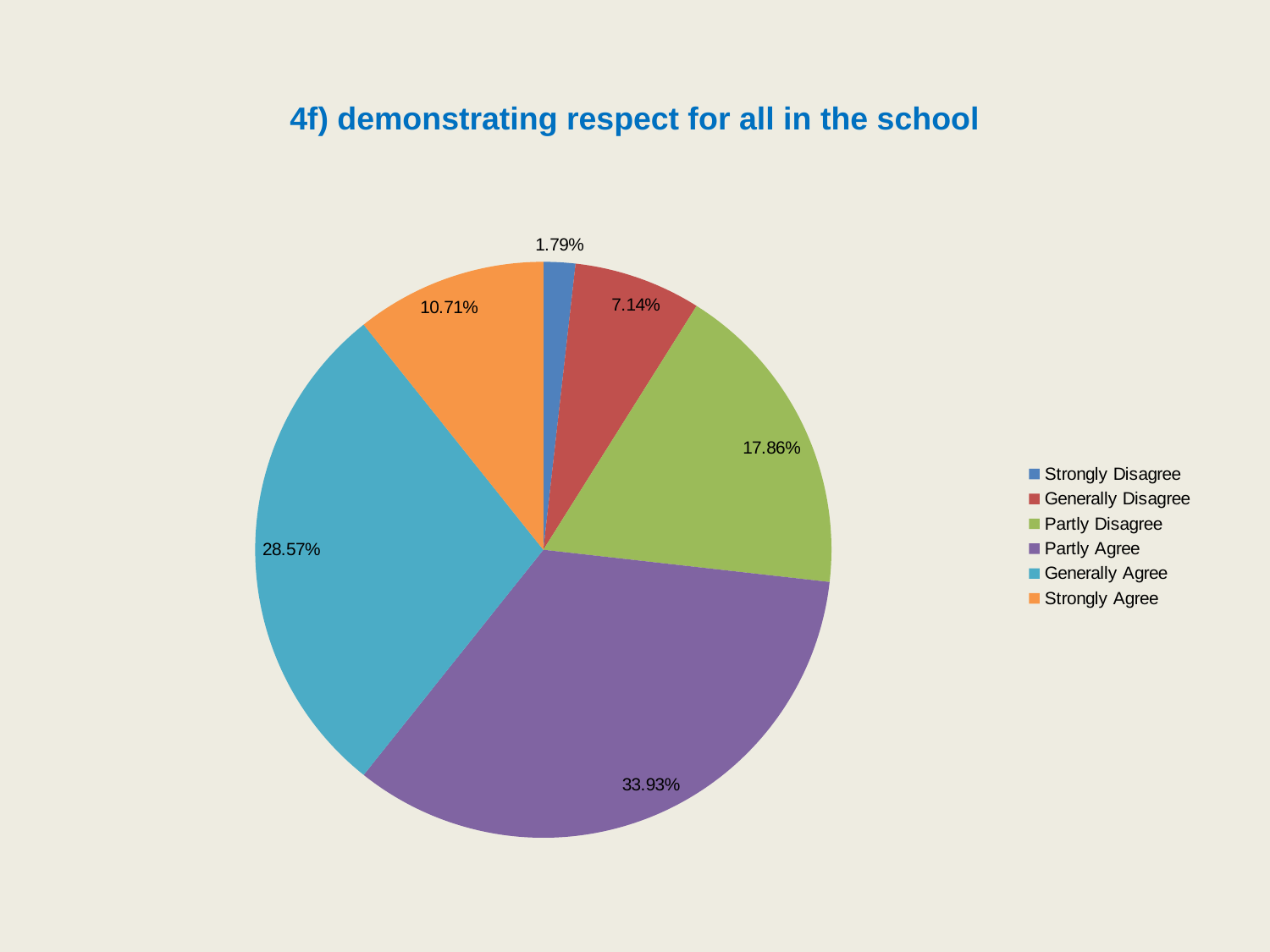
How many categories does the legend list? 6 What type of chart is shown on the slide? pie chart What percentage of responses are Partly Agree? 33.93% Which is larger, Generally Disagree or Strongly Agree? Strongly Agree Which category has the smallest share of the pie? Strongly Disagree What percentage of responses are Strongly Disagree? 1.79% What is the title of the chart? 4f) demonstrating respect for all in the school What percentage of responses are Partly Disagree? 17.86% What colour is the Generally Agree slice? teal/light blue What is the difference between the Partly Agree and Generally Agree shares? 5.36% Which category has the largest share of the pie? Partly Agree What percentage of responses are Generally Agree? 28.57%